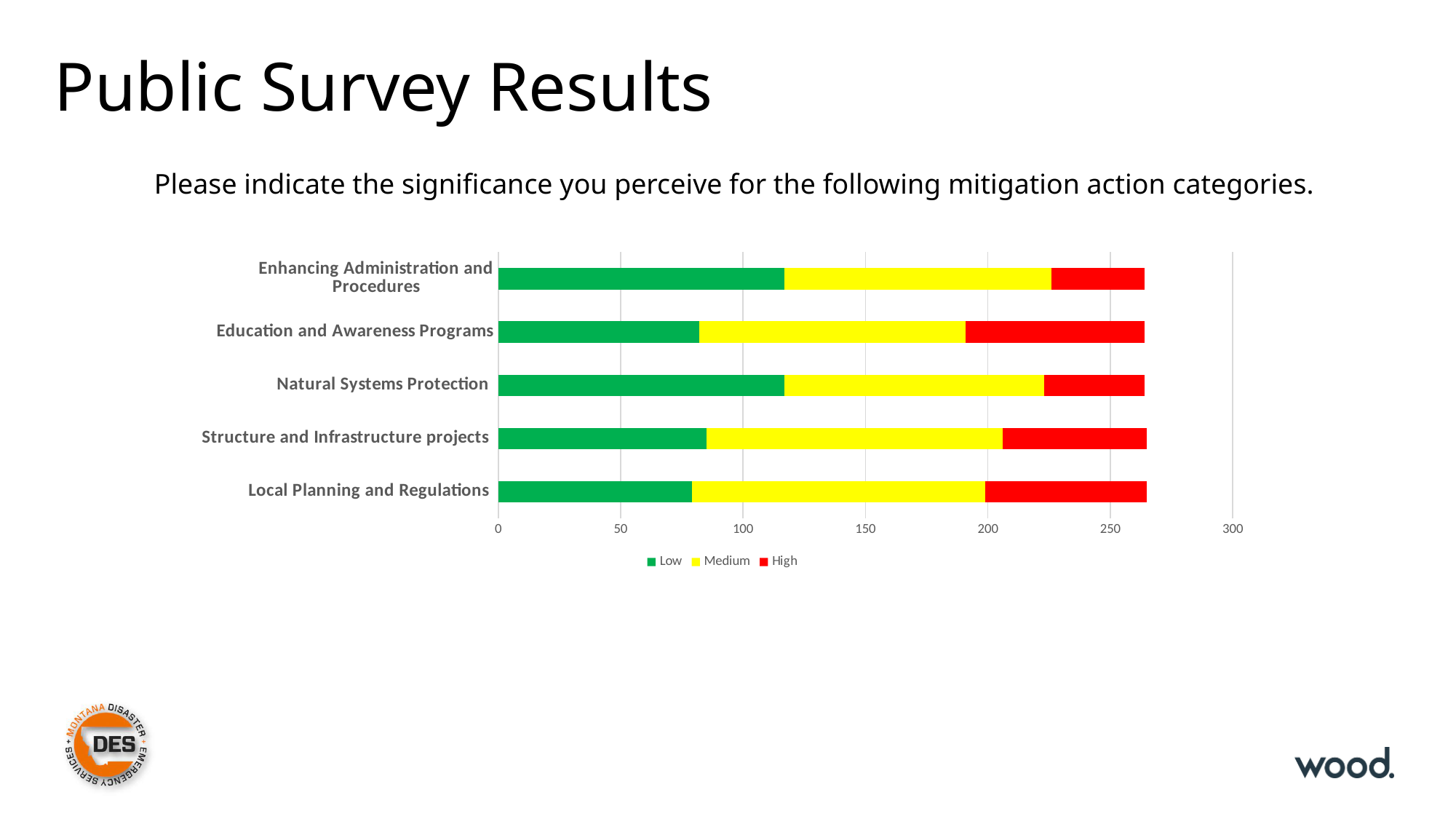
What are the three series named in the legend? Low, Medium, High Is the Low value for Enhancing Administration and Procedures greater or less than 100? greater Which has the larger Low value: Enhancing Administration and Procedures or Education and Awareness Programs? Enhancing Administration and Procedures Is the Low value for Education and Awareness Programs greater or less than 100? less Is the Low value for Local Planning and Regulations greater or less than 50? greater What kind of chart is shown on the slide? Stacked bar chart Which colour represents the High series? Red How many series does the chart legend list? 3 How many mitigation action categories are plotted on the chart? 5 Which has the larger High value: Education and Awareness Programs or Enhancing Administration and Procedures? Education and Awareness Programs